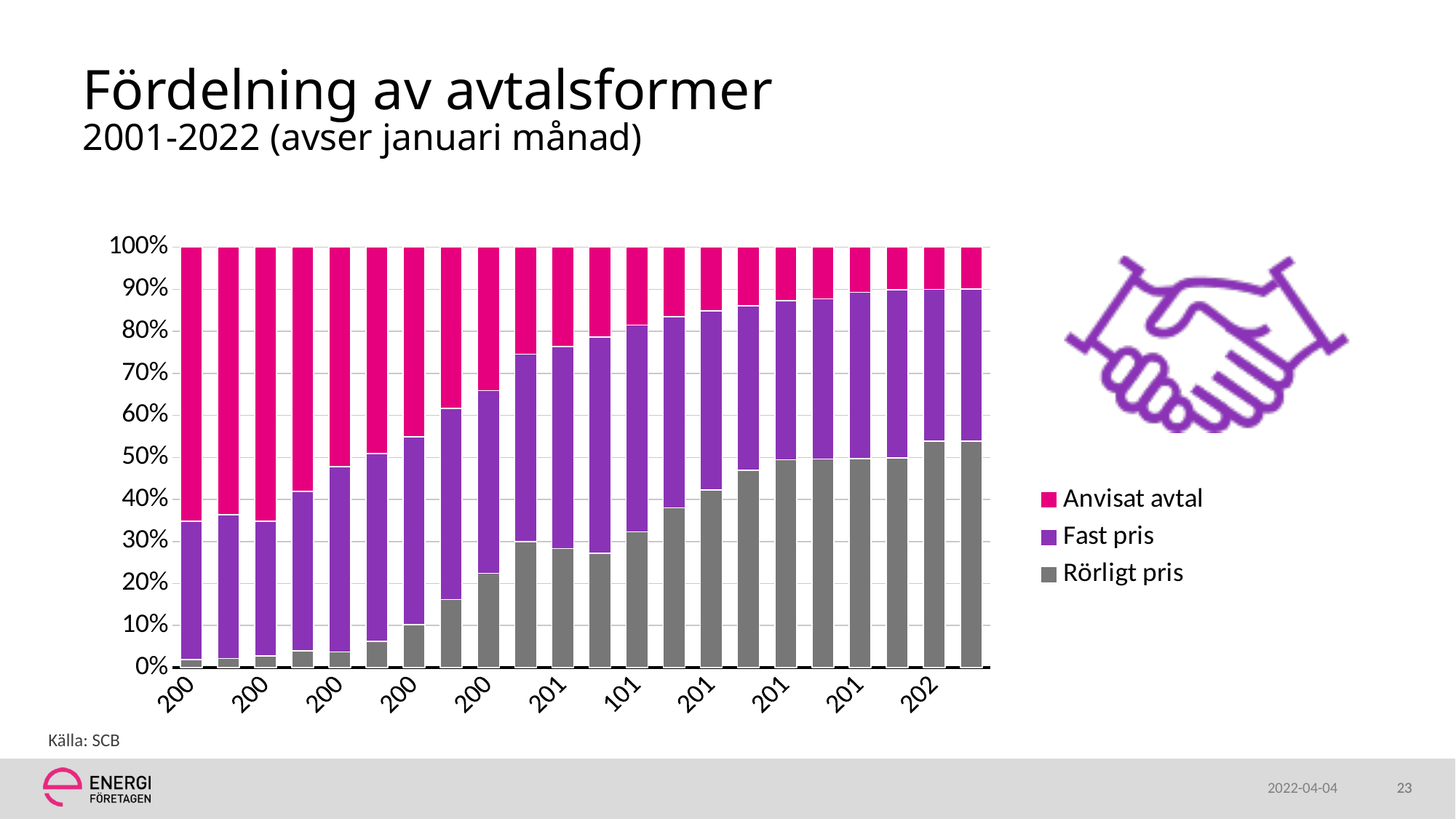
Which series is shown in grey in the chart? Rörligt pris What is the total of each stacked bar in the chart? 100% In the leftmost bar, which series has the largest share? Anvisat avtal In the rightmost bar, is the share of Anvisat avtal greater or less than 20%? less In the rightmost bar, is the share of Rörligt pris greater or less than 50%? greater What kind of chart is shown on the slide? Stacked bar chart In the rightmost bar, which is larger: the share of Rörligt pris or the share of Anvisat avtal? Rörligt pris In the leftmost bar, is the share of Rörligt pris greater or less than 10%? less Does the share of Rörligt pris rise or fall from left to right along the x axis? Rise Does the share of Anvisat avtal rise or fall from left to right along the x axis? Fall How many bars are plotted in the chart? 22 How many series does the chart legend list? 3